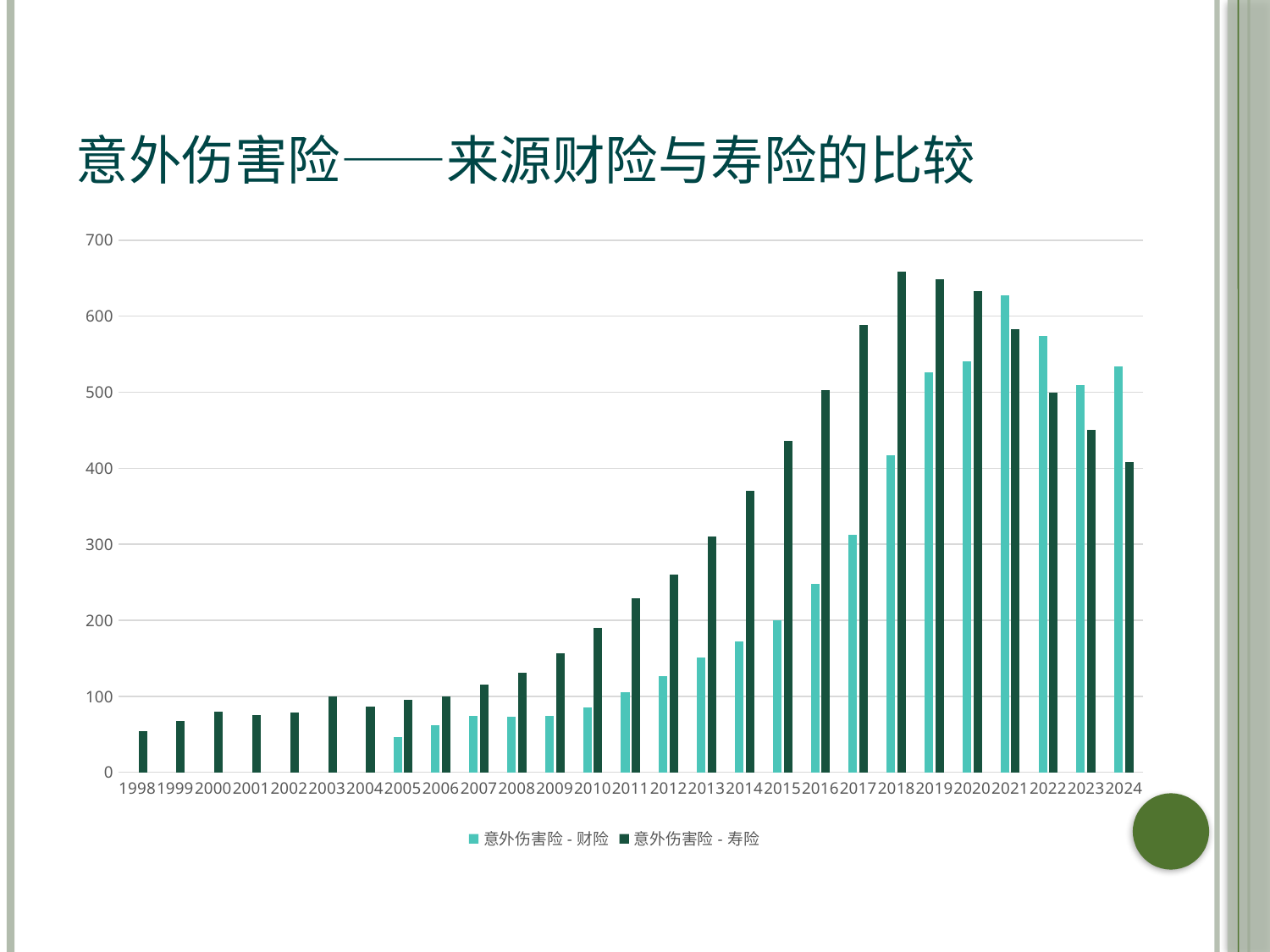
In 2024, which series has the larger value, 意外伤害险 - 财险 or 意外伤害险 - 寿险? 意外伤害险 - 财险 In which year is the value for 意外伤害险 - 寿险 highest? 2018 Is the value for 意外伤害险 - 寿险 in 2018 greater or less than 600? greater In which year is the value for 意外伤害险 - 寿险 lowest? 1998 How many series does the legend list? 2 Is the value for 意外伤害险 - 寿险 in 2024 greater or less than 500? less How many years are shown on the x axis? 27 What kind of chart is shown on the slide? bar chart Is the value for 意外伤害险 - 财险 in 2024 greater or less than 500? greater Does the value for 意外伤害险 - 寿险 rise or fall from 2018 to 2024? fall In 2017, which series has the larger value, 意外伤害险 - 财险 or 意外伤害险 - 寿险? 意外伤害险 - 寿险 In which year is the value for 意外伤害险 - 财险 highest? 2021